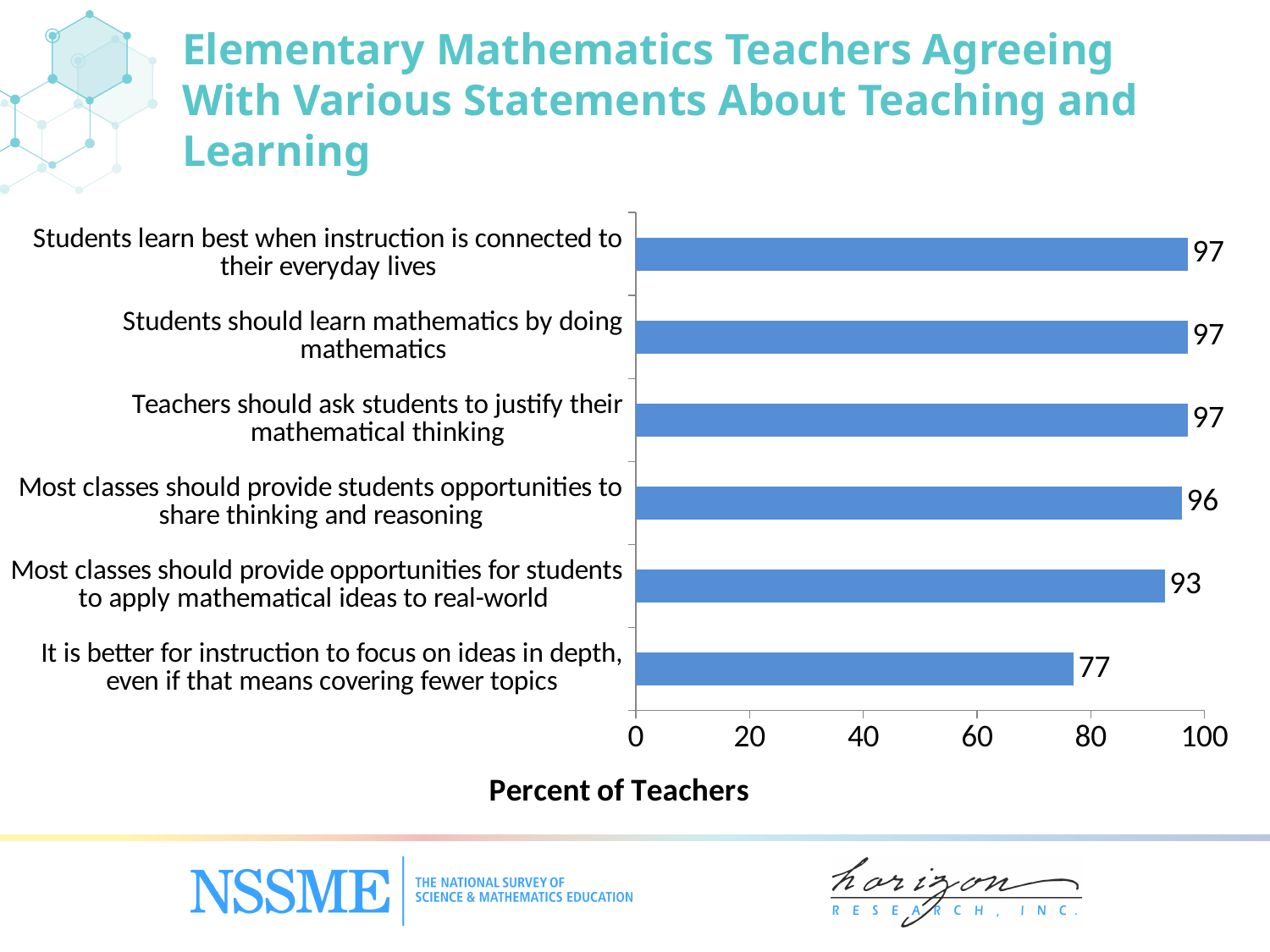
What percent of teachers agree that most classes should provide students opportunities to share thinking and reasoning? 96 What percent of elementary mathematics teachers agree that it is better for instruction to focus on ideas in depth, even if that means covering fewer topics? 77 Which statement has the lowest percent of teachers agreeing? It is better for instruction to focus on ideas in depth, even if that means covering fewer topics Which has a higher percent of teachers agreeing: 'Most classes should provide opportunities for students to apply mathematical ideas to real-world' or 'It is better for instruction to focus on ideas in depth, even if that means covering fewer topics'? Most classes should provide opportunities for students to apply mathematical ideas to real-world How many statements are shown in the chart? 6 What is the difference in percent of teachers between 'Most classes should provide students opportunities to share thinking and reasoning' and 'Most classes should provide opportunities for students to apply mathematical ideas to real-world'? 3 What percent of teachers agree that most classes should provide opportunities for students to apply mathematical ideas to real-world? 93 Is the value for 'It is better for instruction to focus on ideas in depth, even if that means covering fewer topics' greater or less than 80? less What is the label of the horizontal axis? Percent of Teachers What is the difference in percent of teachers between 'Students should learn mathematics by doing mathematics' and 'It is better for instruction to focus on ideas in depth, even if that means covering fewer topics'? 20 What kind of chart is shown on the slide? Bar chart What percent of teachers agree that teachers should ask students to justify their mathematical thinking? 97